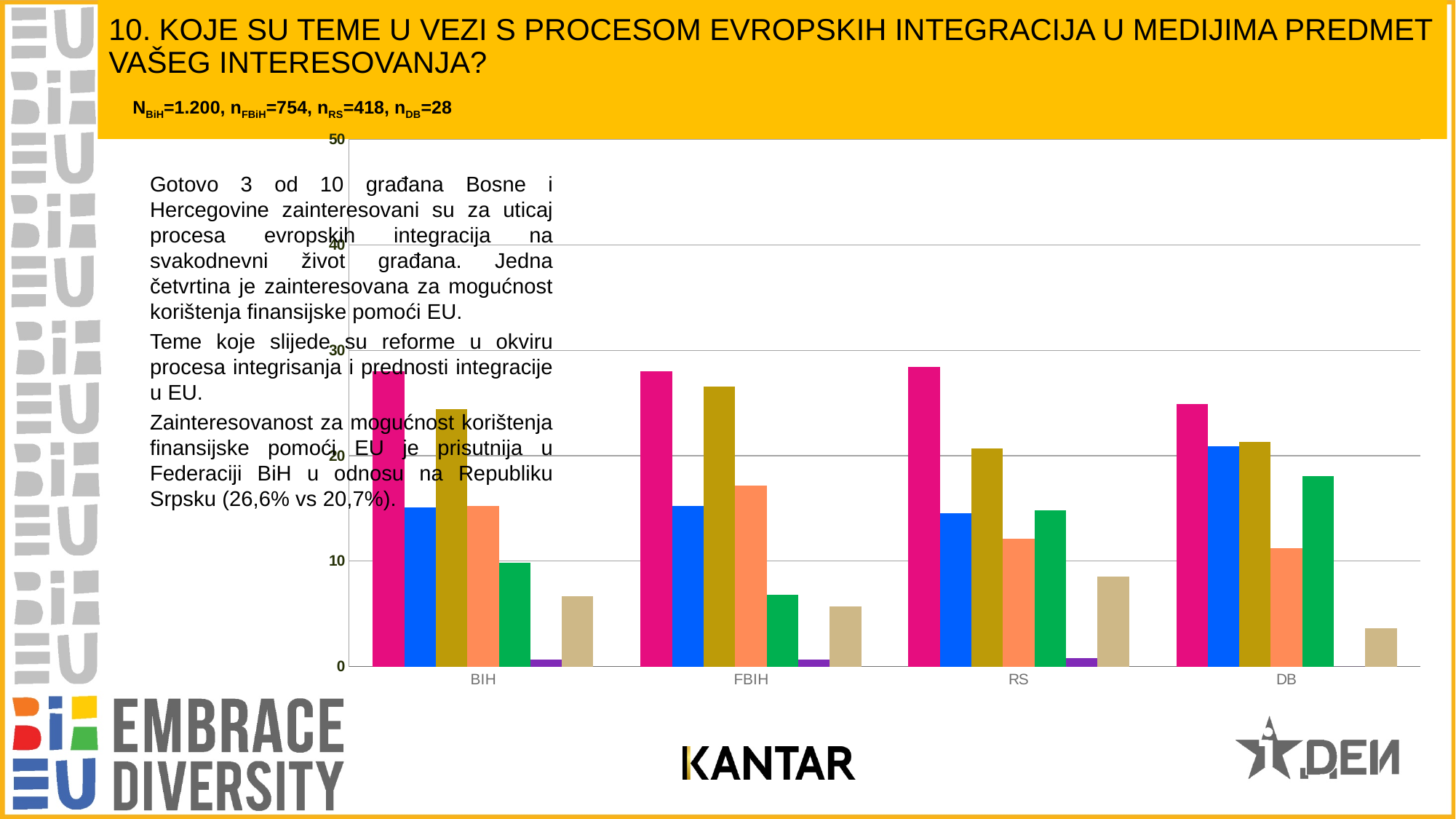
How many categories are shown on the x axis of the chart? 4 For RS, which is larger: the magenta bar or the olive bar? the magenta bar Is the value of the olive bar for FBIH greater or less than 20? greater Which category has the tallest green bar? DB What kind of chart is shown on the slide? bar chart Is the value of the tan bar for DB greater or less than 10? less What are the category labels on the x axis of the chart? BIH, FBIH, RS, DB Is the value of the green bar for FBIH greater or less than 10? less Which category has the lowest tan bar? DB For DB, which is larger: the green bar or the orange bar? the green bar